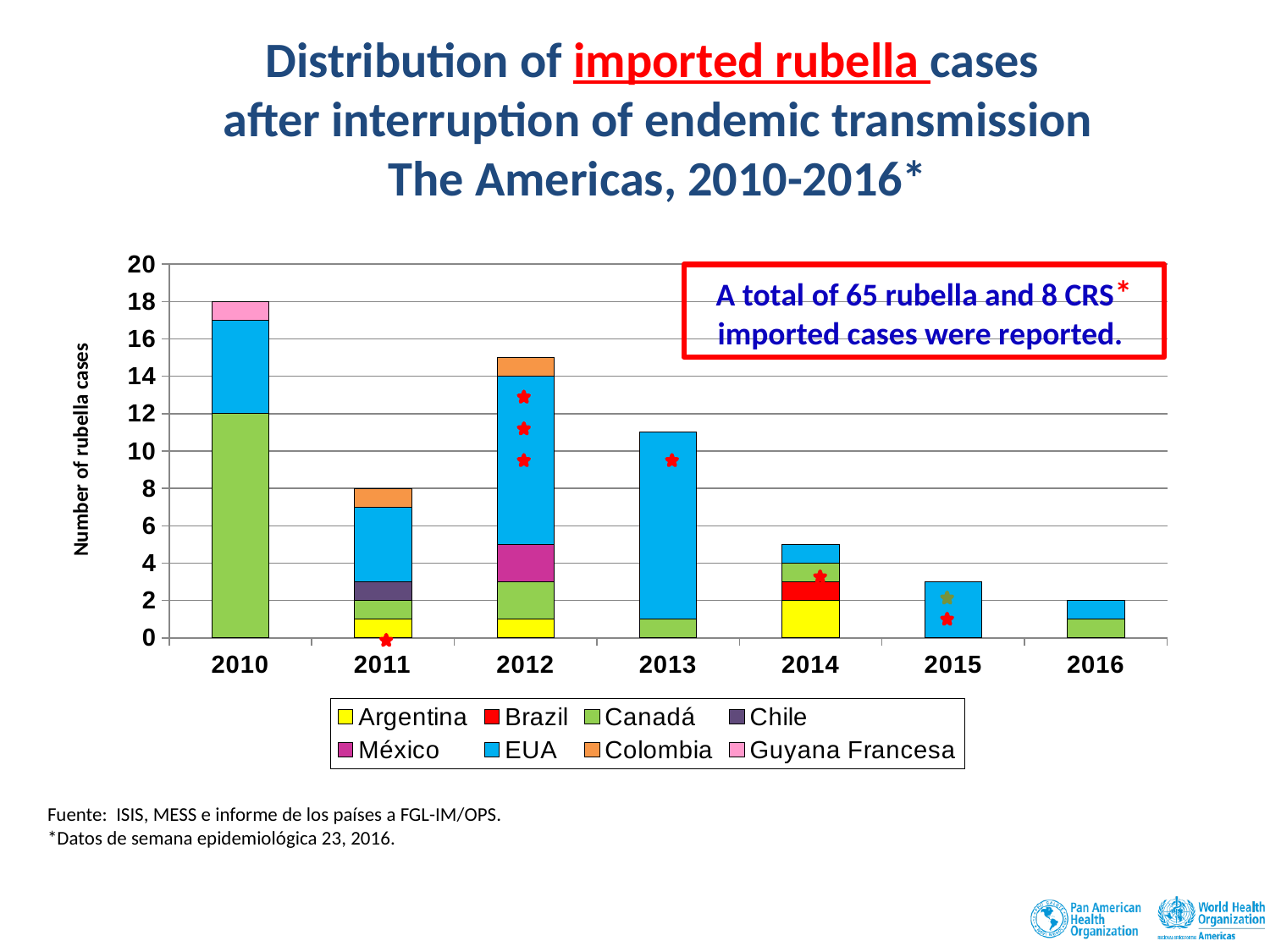
How many series does the chart's legend list? 8 Which year has the lowest total number of imported rubella cases? 2016 Is the total for 2014 greater or less than 6? less How many years are shown along the x axis of the chart? 7 What is the total number of rubella cases for 2016? 2 Is the total for 2013 greater or less than 10? greater Which year has a taller bar, 2012 or 2013? 2012 What is the total number of rubella cases for 2010? 18 Which year has the highest total number of imported rubella cases? 2010 What is the total number of rubella cases for 2011? 8 What kind of chart is shown on the slide? Stacked bar chart Do the total number of cases generally rise or fall from 2010 to 2016? fall